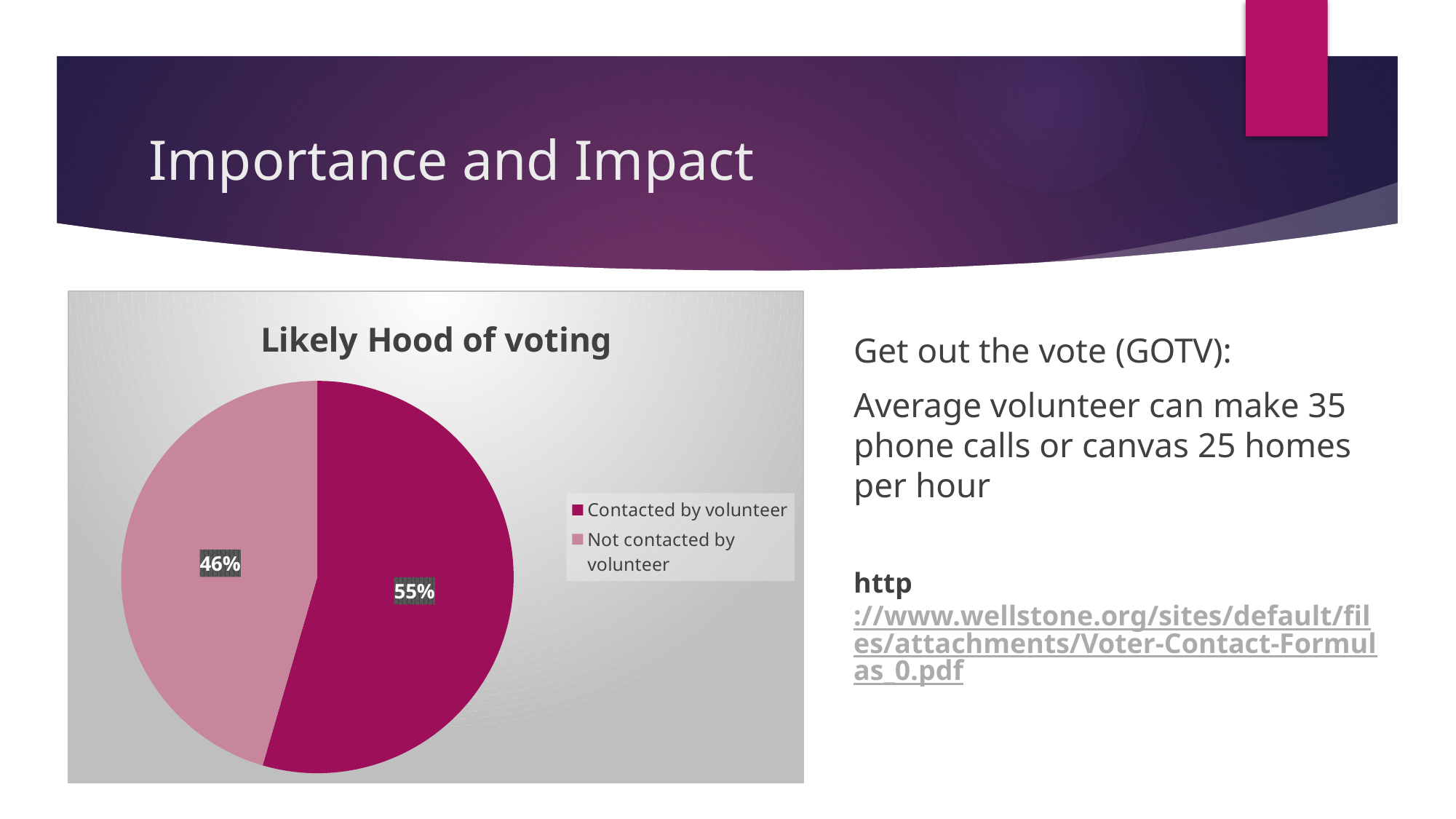
Which slice of the pie is the largest? Contacted by volunteer Which is larger: the 'Contacted by volunteer' slice or the 'Not contacted by volunteer' slice? Contacted by volunteer Which legend entry is shown in the darker magenta colour? Contacted by volunteer How many entries does the chart legend list? 2 What percentage is shown for the 'Contacted by volunteer' slice? 55% What is the title of the chart? Likely Hood of voting How many slices does the pie chart have? 2 By how many percentage points does the 'Contacted by volunteer' slice exceed the 'Not contacted by volunteer' slice? 9 percentage points What percentage is shown for the 'Not contacted by volunteer' slice? 46% Which slice of the pie is the smallest? Not contacted by volunteer What share of the pie does the 'Not contacted by volunteer' slice represent? 46% What kind of chart is shown on the slide? Pie chart